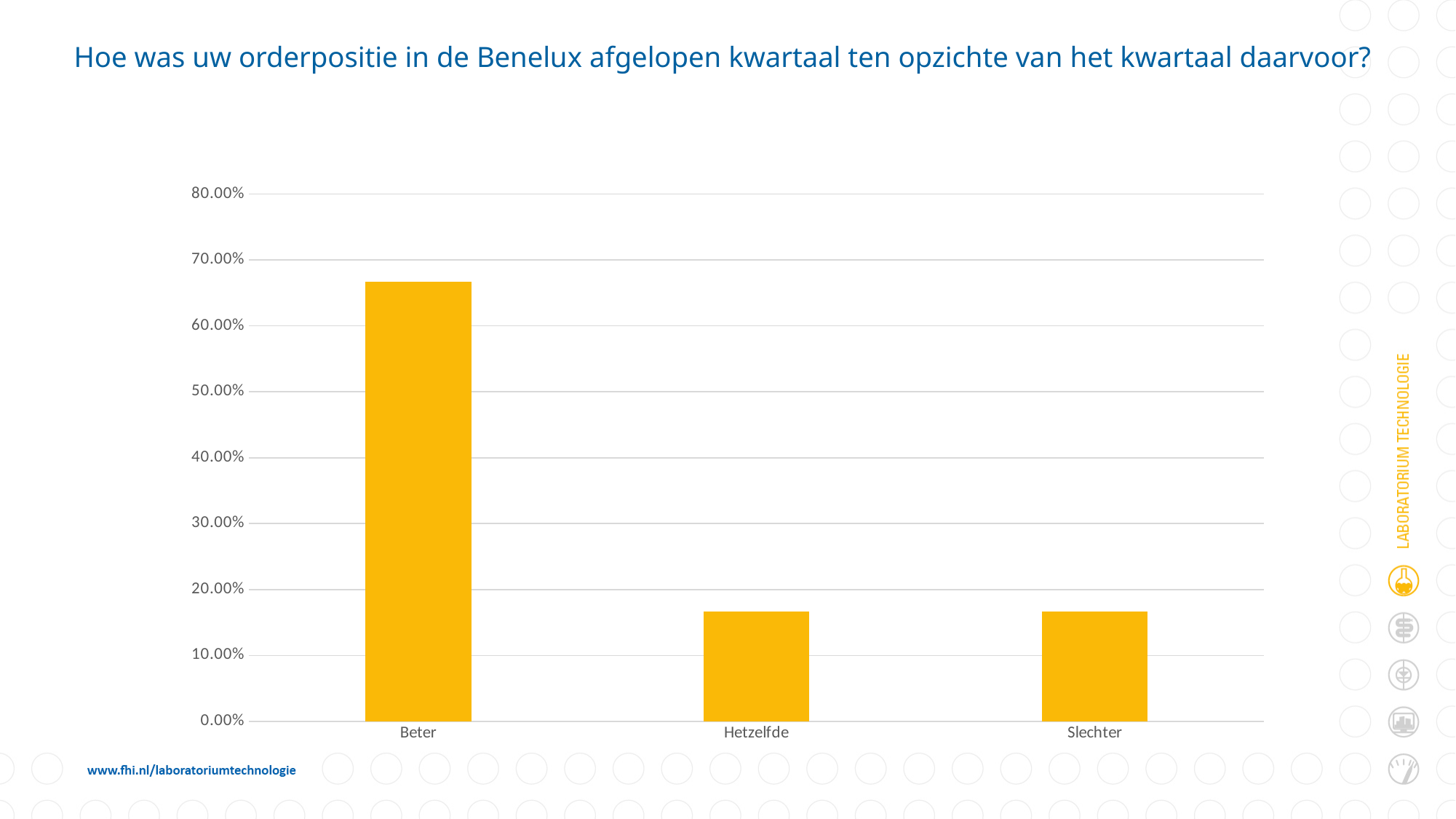
Is the value for Slechter greater or less than 10.00%? greater Is the value for Beter greater or less than 60.00%? greater What colour are the bars in the chart? yellow Is the value for Hetzelfde greater or less than 20.00%? less Which category has the highest value in the chart? Beter What is the title of the chart on the slide? Hoe was uw orderpositie in de Benelux afgelopen kwartaal ten opzichte van het kwartaal daarvoor? How many categories are shown on the x axis of the chart? 3 What kind of chart is shown on the slide? bar chart Which is larger, the value for Beter or the value for Slechter? Beter